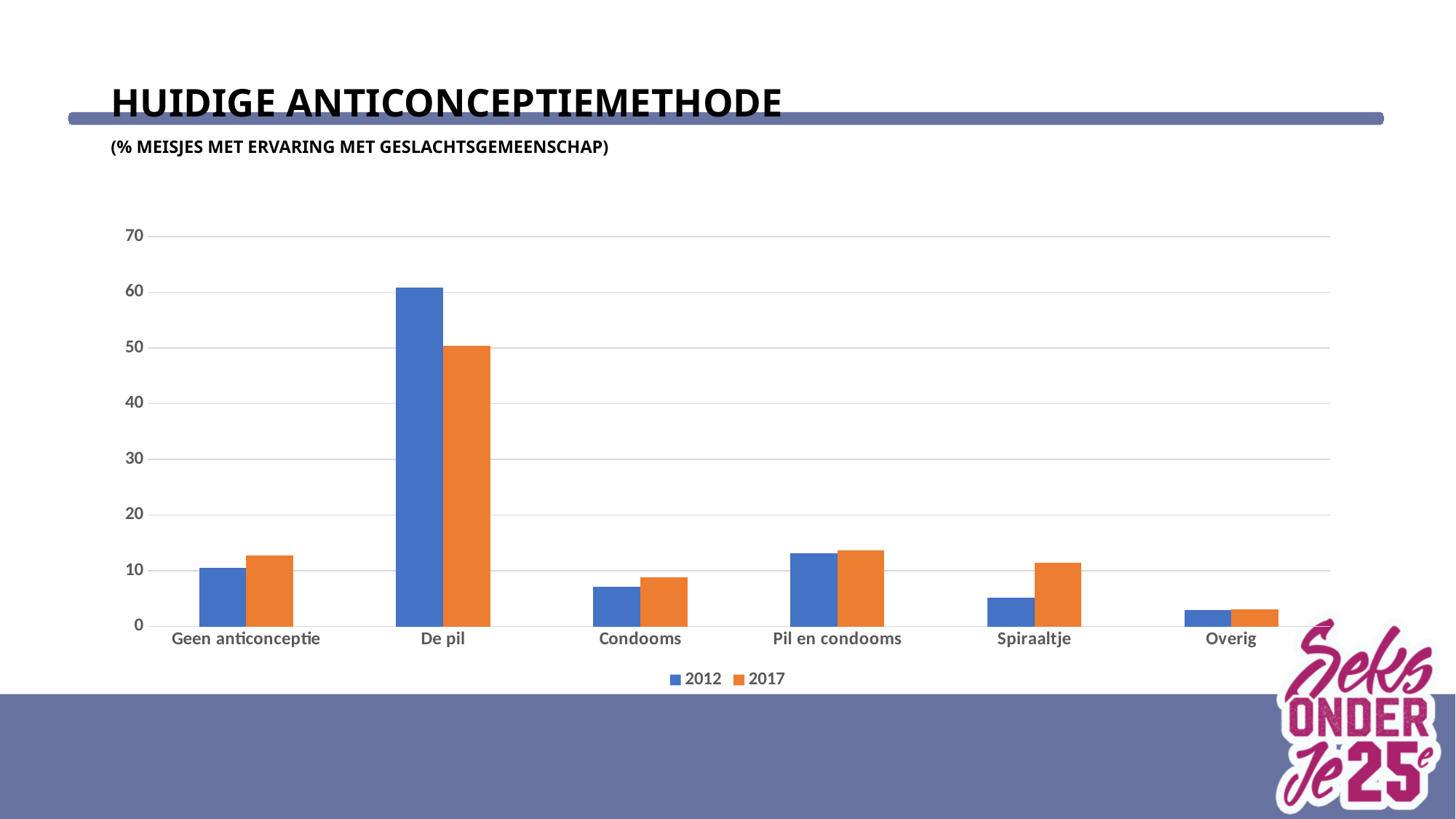
Which category has the highest value for 2017? De pil Is the value for Geen anticonceptie in 2017 greater or less than 10? greater Which category has the lowest value for 2012? Overig For De pil, which year has the larger value, 2012 or 2017? 2012 Which category has the lowest value for 2017? Overig Is the value for De pil in 2017 greater or less than 60? less Which category has the highest value for 2012? De pil For Spiraaltje, which year has the larger value, 2012 or 2017? 2017 How many series does the legend list? 2 What kind of chart is shown on the slide? bar chart How many contraception categories are shown on the x axis? 6 Which years are listed in the legend? 2012 and 2017